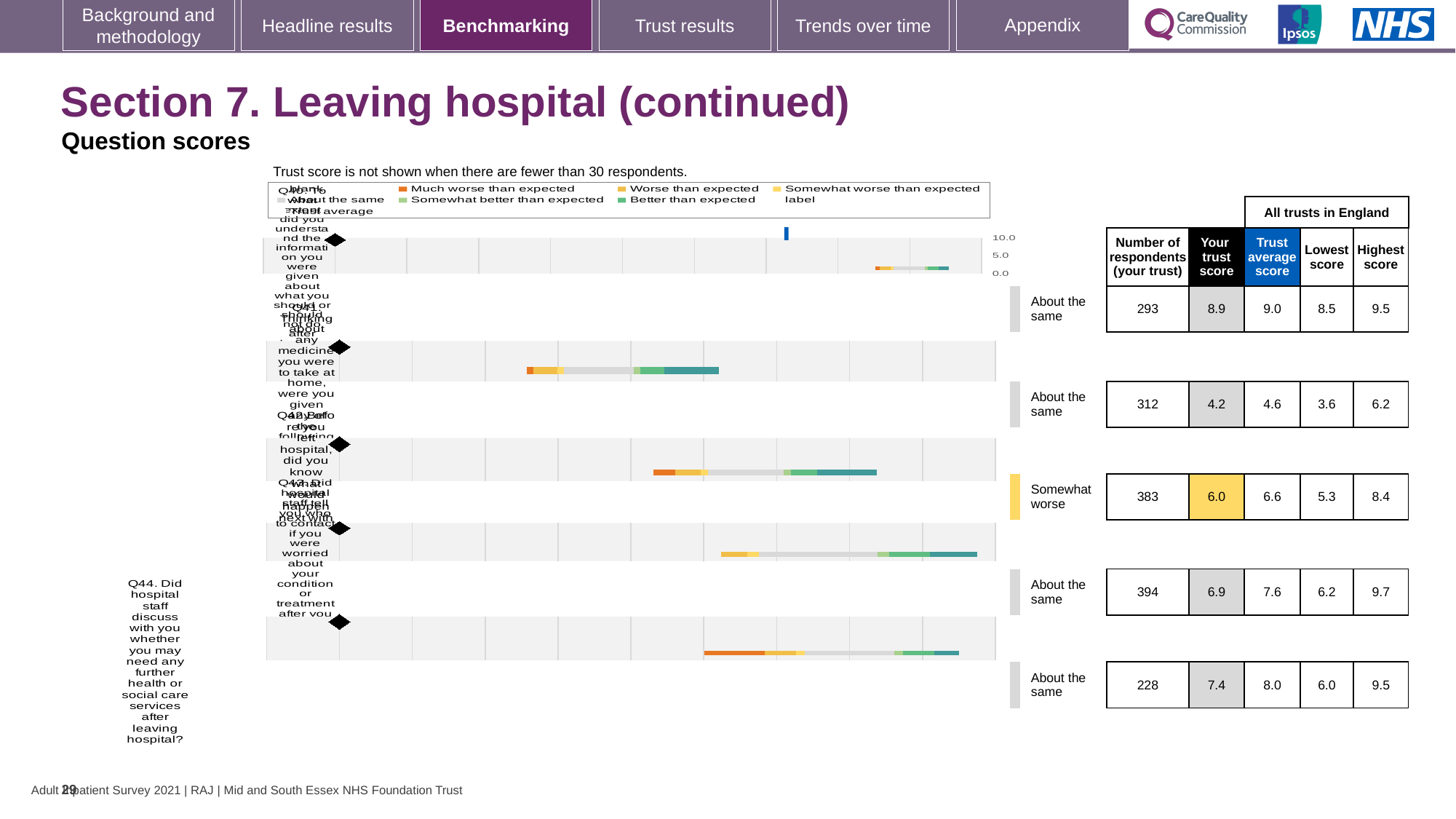
What is the trust average score for Q44 (further health or social care services after leaving hospital)? 8.0 Which question row has the highest number of respondents? the fourth row (394 respondents) What kind of chart is used to show the question scores on this slide? bar chart What is the difference between the trust average score and the trust's score for Q44 (further health or social care services after leaving hospital)? 0.6 For Q44 (further health or social care services after leaving hospital), which is larger: the trust's score or the trust average score? the trust average score What is the highest score across all trusts in England for Q44 (further health or social care services after leaving hospital)? 9.5 What is the number of respondents for Q44 (Did hospital staff discuss with you whether you may need any further health or social care services after leaving hospital?)? 228 What is the trust's score for the first question row in the chart (293 respondents)? 8.9 How many questions (rows) are shown in the question scores chart? 5 What is the trust's score for Q44 (further health or social care services after leaving hospital)? 7.4 Which question row is rated 'Somewhat worse' than expected, and what is its trust score? the third row, 6.0 What is the title of this slide? Section 7. Leaving hospital (continued)